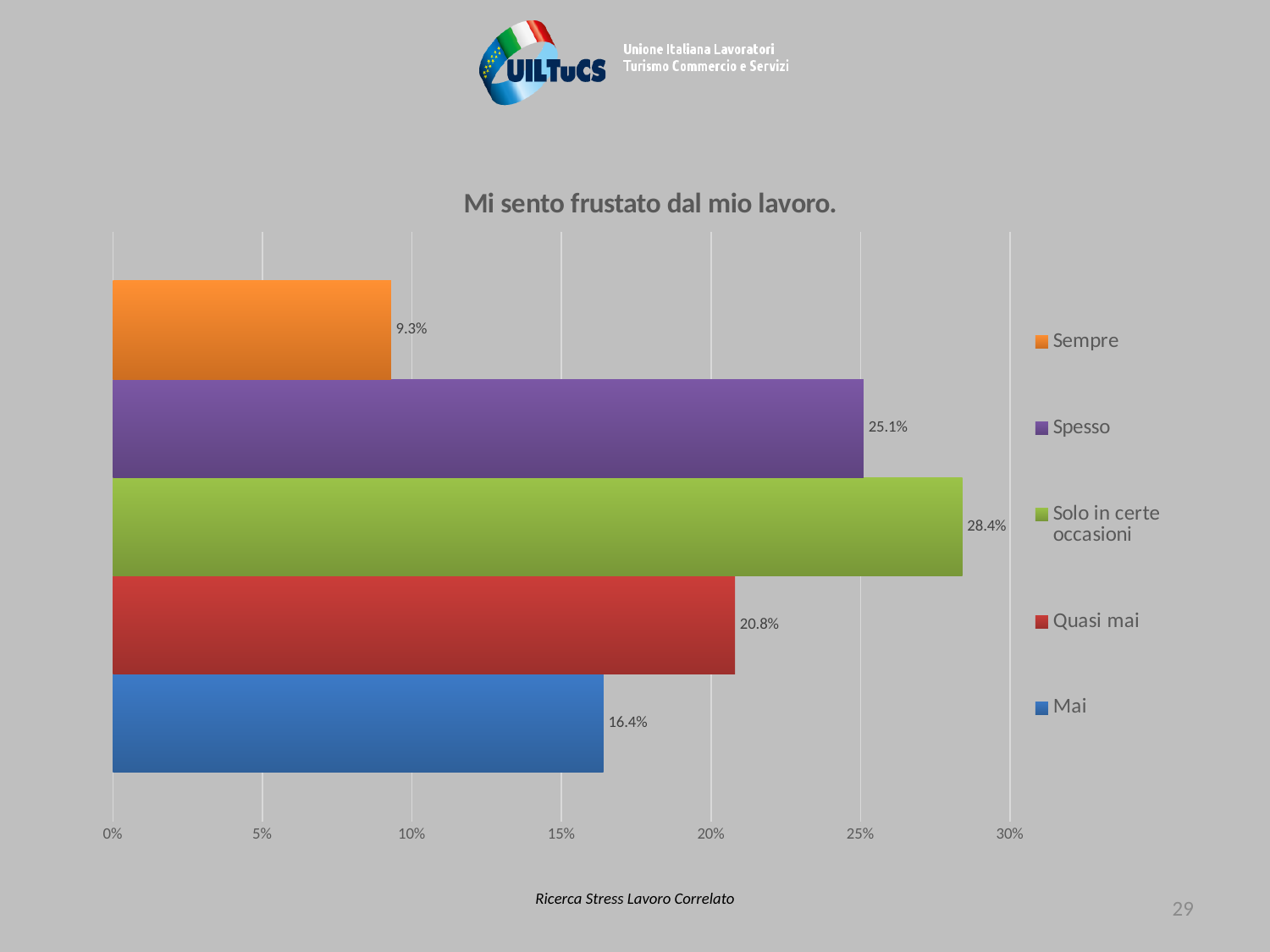
What is the value for Solo in certe occasioni? 28.4% What kind of chart is shown on the slide? Bar chart What is the value for Sempre? 9.3% Which category has the highest value? Solo in certe occasioni Which is larger, the value for Quasi mai or the value for Mai? Quasi mai What is the value for Mai? 16.4% What is the value for Spesso? 25.1% What is the difference between the values for Spesso and Sempre? 15.8% Which category has the lowest value? Sempre How many categories does the legend list? 5 What is the value for Quasi mai? 20.8% What is the title of the chart? Mi sento frustato dal mio lavoro.